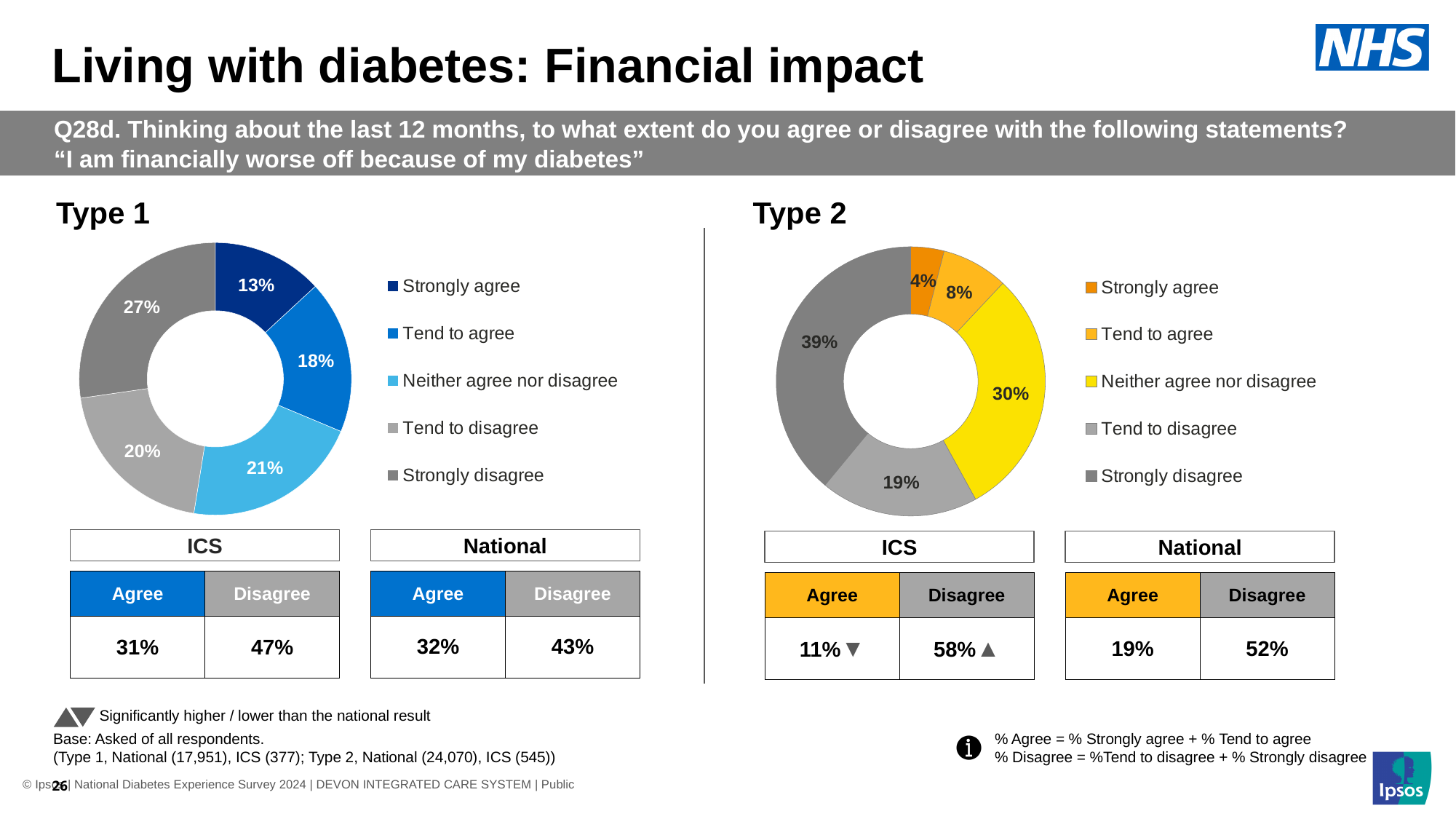
In the Type 1 chart, what is the difference between the 'Neither agree nor disagree' share and the 'Tend to agree' share? 3% In the Type 2 chart, is the share for 'Neither agree nor disagree' larger or smaller than the share for 'Tend to disagree'? larger In the Type 2 chart, what percentage of respondents said they strongly disagree? 39% In the Type 2 chart, what is the combined share of 'Strongly agree' and 'Tend to agree'? 12% In the Type 1 chart, what is the difference between the 'Strongly disagree' share and the 'Strongly agree' share? 14% In the Type 1 chart, what is the 'Tend to disagree' share? 20% In the Type 2 chart, what colour represents 'Neither agree nor disagree'? Yellow In the Type 1 chart, what percentage of respondents said they strongly agree? 13% In the Type 2 chart, which response category has the smallest share? Strongly agree What kind of chart is used for the Type 2 data? Doughnut chart How many response categories does the Type 1 chart show? 5 In the Type 1 chart, which response category has the largest share? Strongly disagree